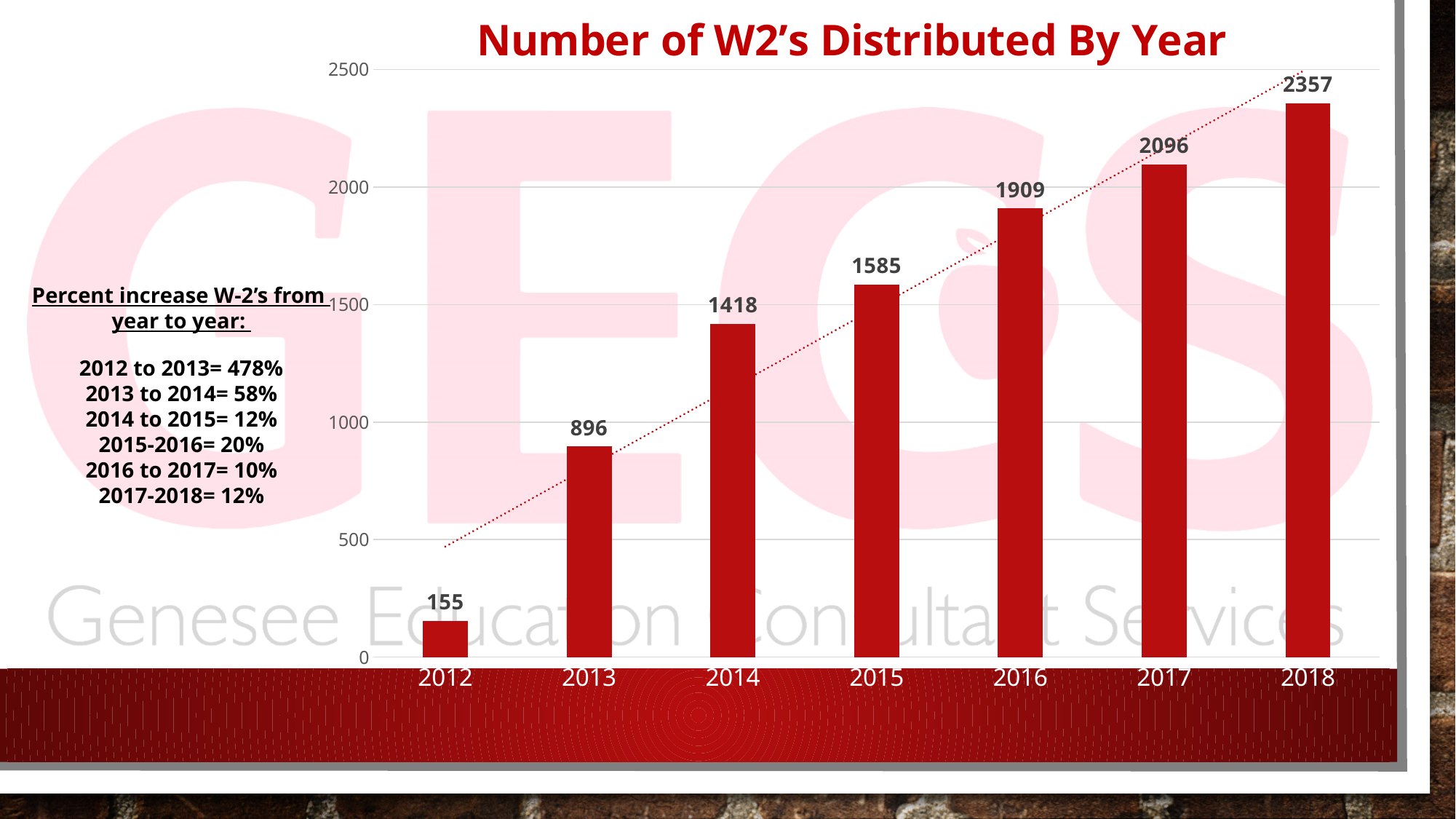
What kind of chart is shown on the slide? bar chart What is the difference between the number of W2's distributed in 2013 and in 2012? 741 Do the values rise or fall from 2012 to 2018? rise Which year has the lowest number of W2's distributed? 2012 Is the value for 2016 greater or less than 2000? less What is the difference between the number of W2's distributed in 2018 and in 2017? 261 What is the number of W2's distributed in 2017? 2096 Which year had more W2's distributed, 2015 or 2016? 2016 How many years are shown on the x axis of the chart? 7 What is the number of W2's distributed in 2014? 1418 What is the title of the chart? Number of W2's Distributed By Year Which year has the highest number of W2's distributed? 2018